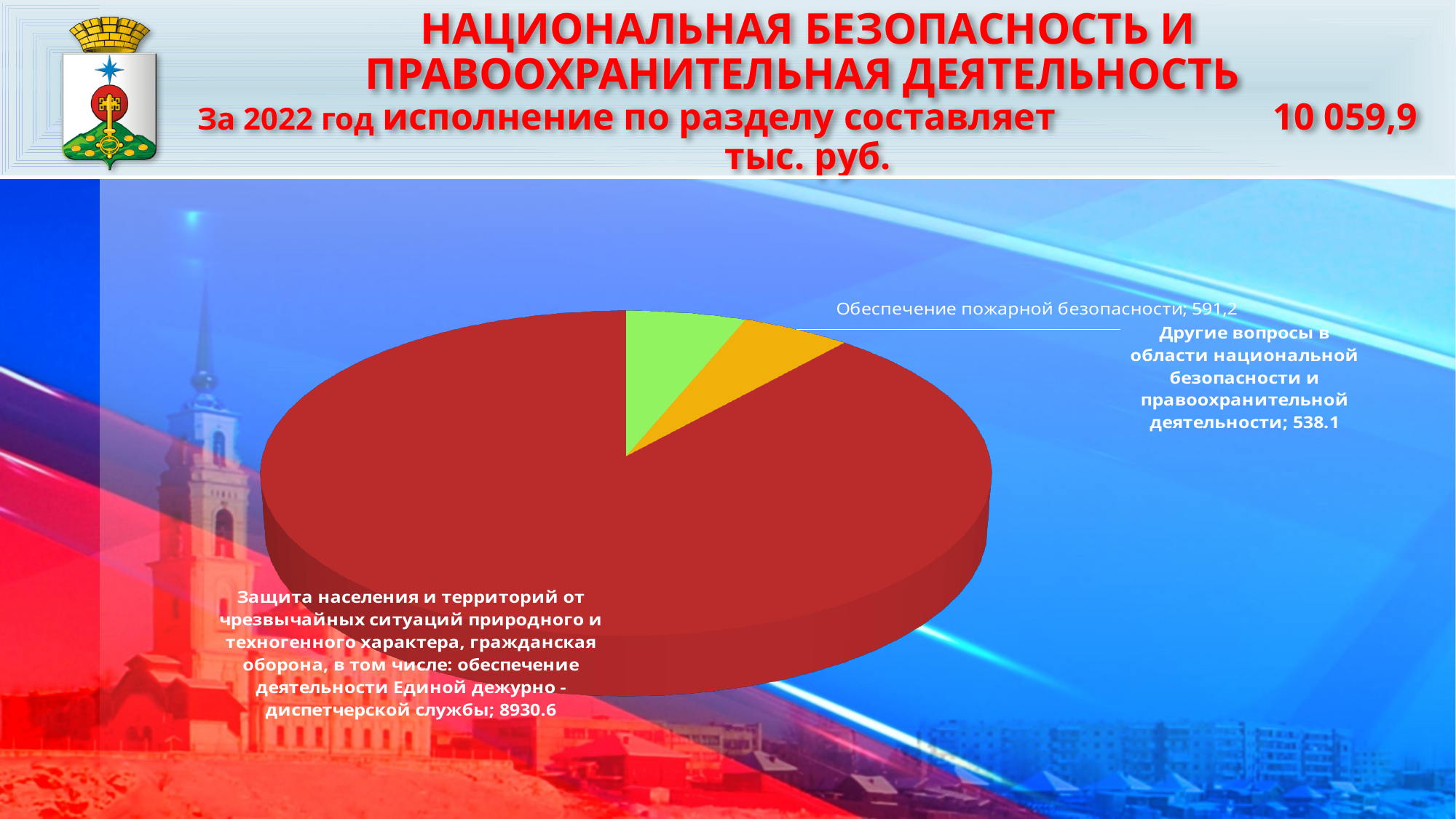
Which category has the largest slice of the pie? Защита населения и территорий от чрезвычайных ситуаций природного и техногенного характера, гражданская оборона, в том числе: обеспечение деятельности Единой дежурно-диспетчерской службы How many slices does the pie chart have? 3 What is the value for "Защита населения и территорий от чрезвычайных ситуаций природного и техногенного характера, гражданская оборона, в том числе: обеспечение деятельности Единой дежурно-диспетчерской службы"? 8930.6 Which is larger: "Обеспечение пожарной безопасности" or "Другие вопросы в области национальной безопасности и правоохранительной деятельности"? Обеспечение пожарной безопасности What type of chart is shown on the slide? Pie chart Which category has the smallest slice of the pie? Другие вопросы в области национальной безопасности и правоохранительной деятельности What is the value for "Обеспечение пожарной безопасности"? 591,2 According to the slide header, what is the total execution for the section in 2022? 10 059,9 тыс. руб. What is the difference between the largest slice (8930.6) and "Обеспечение пожарной безопасности" (591,2)? 8339.4 What is the difference between the values for "Обеспечение пожарной безопасности" and "Другие вопросы в области национальной безопасности и правоохранительной деятельности"? 53.1 What is the value for "Другие вопросы в области национальной безопасности и правоохранительной деятельности"? 538.1